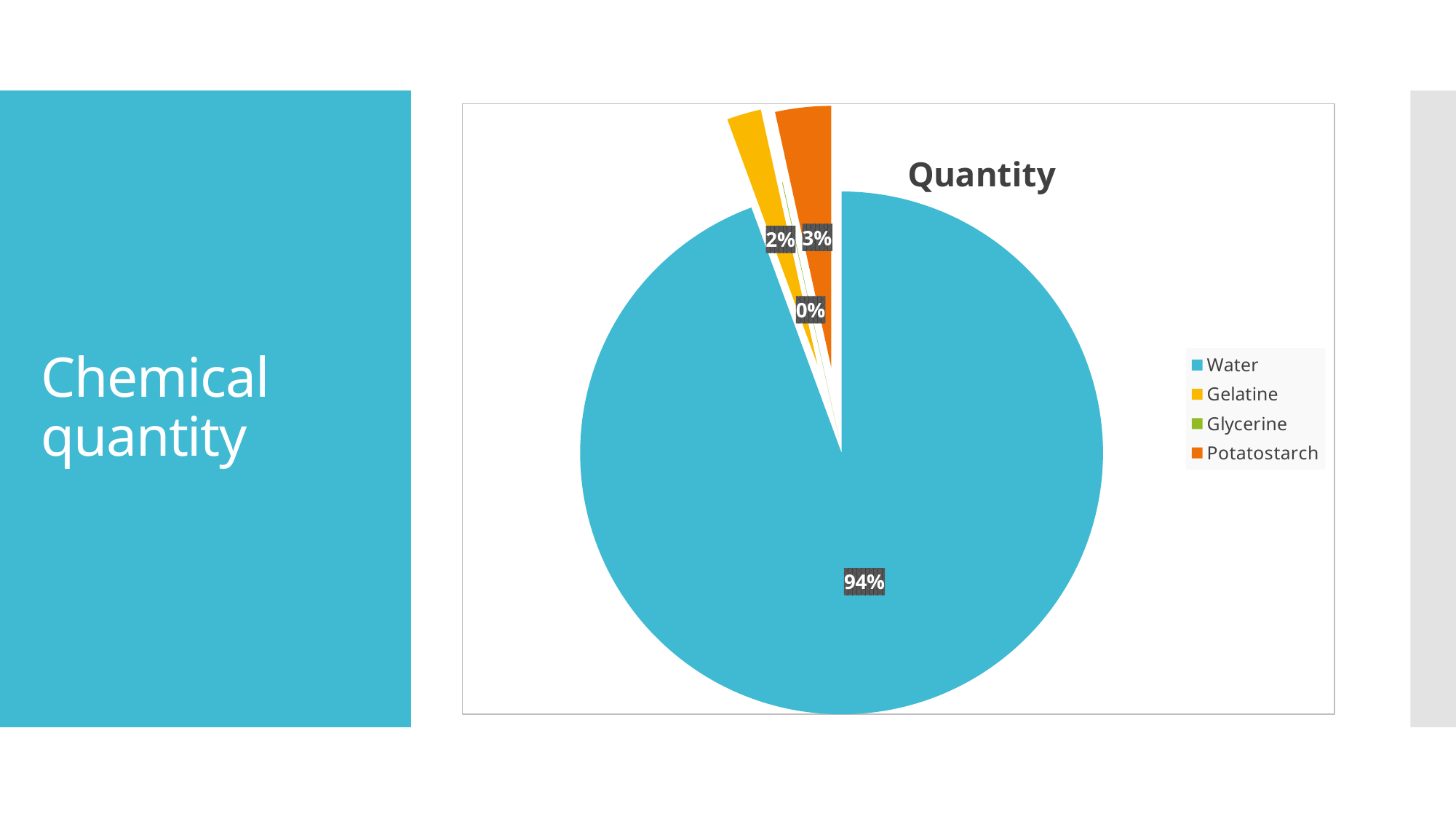
What is the difference in percentage points between Water and Potatostarch? 91% How many categories are shown in the pie chart? 4 Which category has the largest share of the pie? Water Which category has the smallest share of the pie? Glycerine What percentage is shown for Glycerine? 0% What kind of chart is shown on the slide? Pie chart What percentage of the pie does Water account for? 94% What percentage is shown for Gelatine? 2% What colour represents Water in the pie chart? Blue What is the title of the chart? Quantity Which has a larger share, Potatostarch or Gelatine? Potatostarch What percentage is shown for Potatostarch? 3%